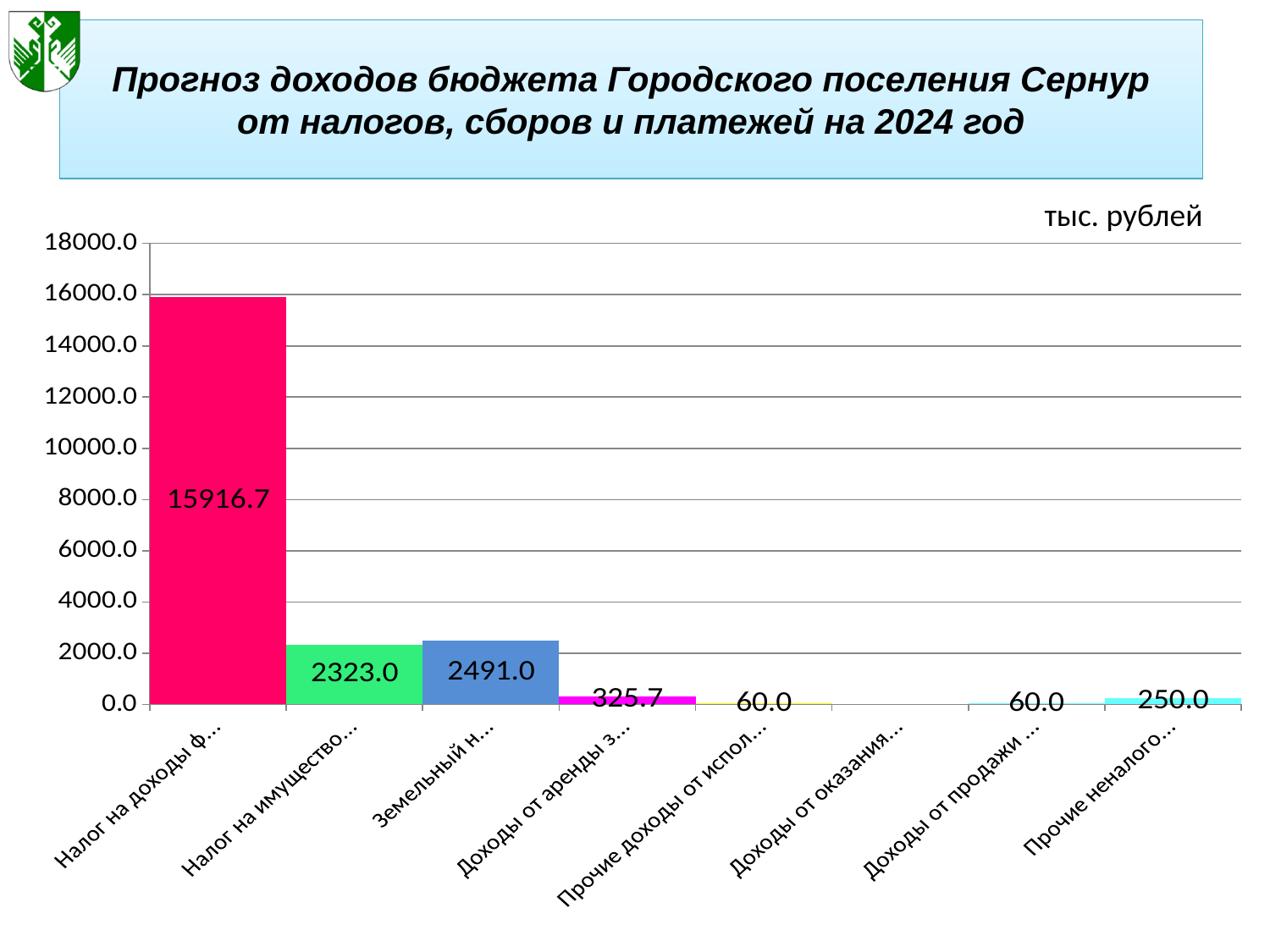
What is the difference between the value for the category beginning 'Земельный' (2491.0) and the value for the category beginning 'Налог на имущество' (2323.0)? 168.0 What unit of measurement is indicated above the chart? тыс. рублей What kind of chart is shown on the slide? bar chart How many categories are shown along the x axis of the chart? 8 What is the value of the bar for the category whose label begins 'Налог на доходы'? 15916.7 What is the value of the bar for the category whose label begins 'Прочие неналого'? 250.0 Which category has the highest value in the chart? Налог на доходы ф... What is the value of the bar for the category whose label begins 'Земельный'? 2491.0 Is the value for the category beginning 'Налог на доходы' greater or less than 14000.0? greater What is the value of the bar for the category whose label begins 'Налог на имущество'? 2323.0 Which is larger: the value for the category beginning 'Земельный' or the value for the category beginning 'Налог на имущество'? Земельный н... What is the value of the bar for the category whose label begins 'Доходы от аренды'? 325.7